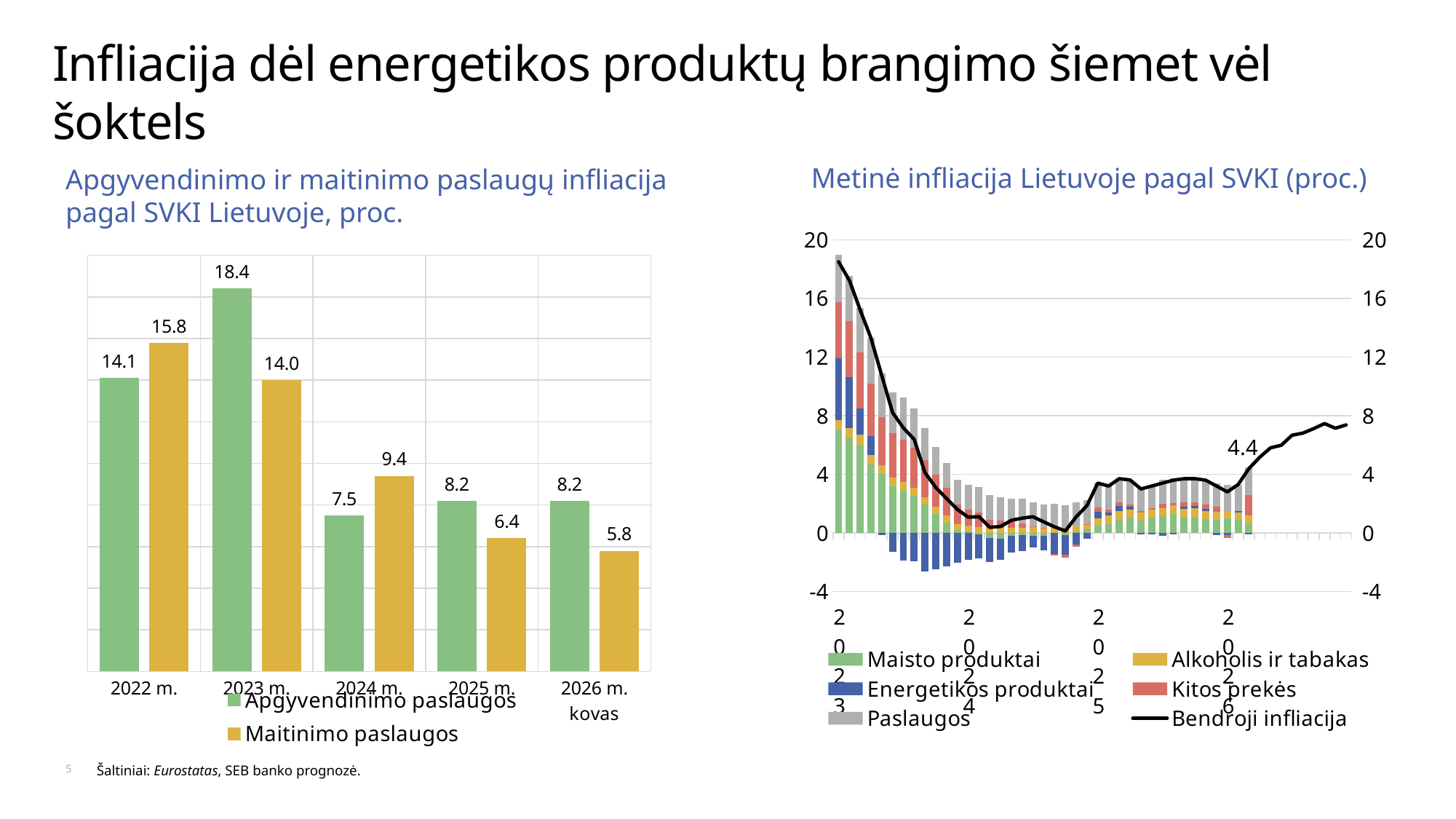
How many categories are shown on the x axis of the left chart? 5 In the left chart (Apgyvendinimo ir maitinimo paslaugų infliacija), what is the value for Apgyvendinimo paslaugos in 2023 m.? 18.4 In the right chart, what value is labelled on the Bendroji infliacija line? 4.4 In the left chart, in which period is Maitinimo paslaugos lowest? 2026 m. kovas In the left chart, in which year is Apgyvendinimo paslaugos highest? 2023 m. How many series does the legend of the left chart list? 2 In the left chart, what is the difference between Maitinimo paslaugos and Apgyvendinimo paslaugos in 2022 m.? 1.7 In the left chart, which series has the larger value in 2025 m.? Apgyvendinimo paslaugos In the left chart, what is the value for Maitinimo paslaugos in 2024 m.? 9.4 How many series does the legend of the right chart (Metinė infliacija Lietuvoje pagal SVKI) list? 6 What kind of chart is the left chart (Apgyvendinimo ir maitinimo paslaugų infliacija)? bar chart